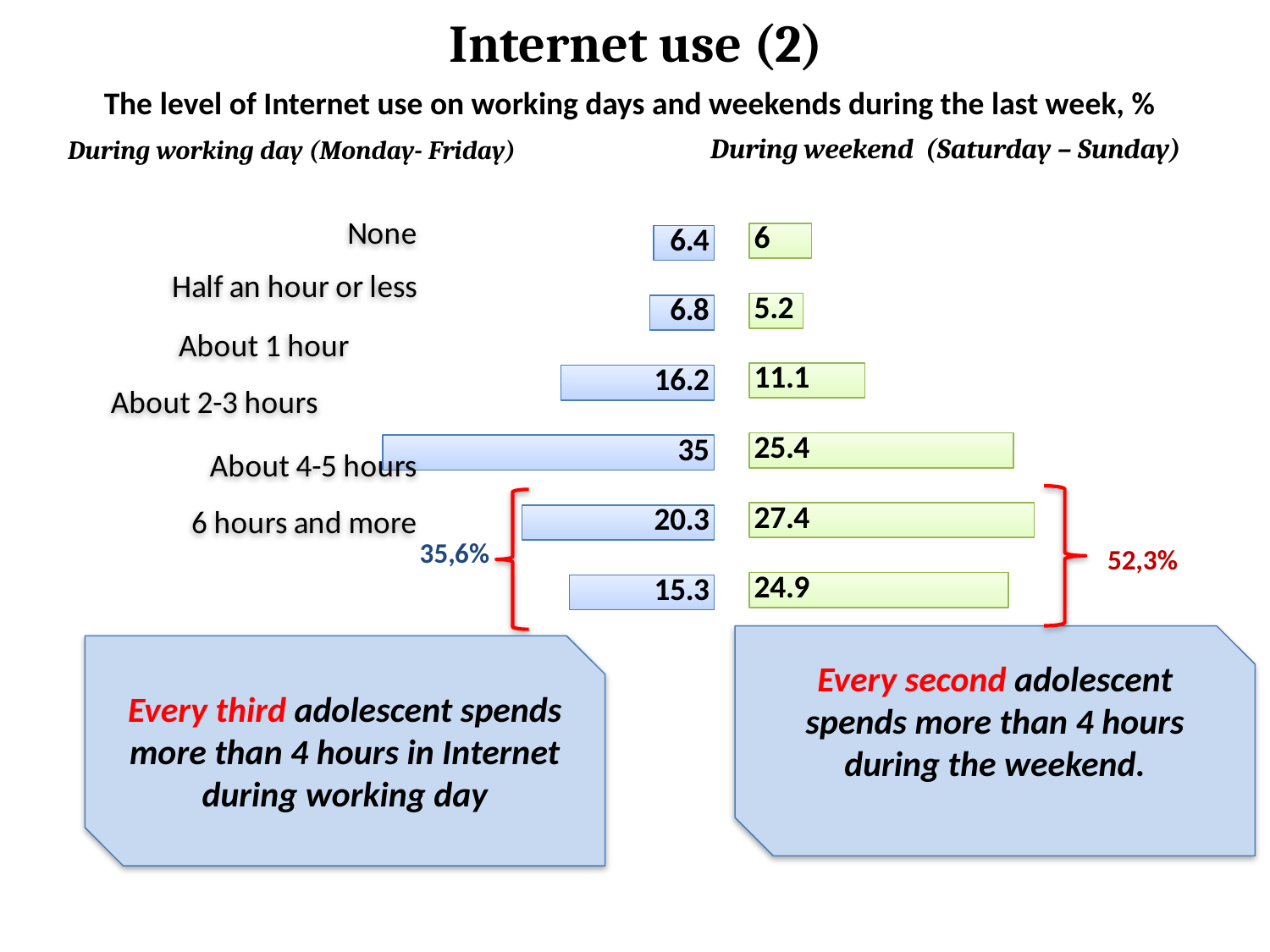
In the 'During working day (Monday- Friday)' chart, what is the value for 'Half an hour or less'? 6.8 What is the difference between the 'About 2-3 hours' values in the working day chart and the weekend chart? 9.6 What type of chart is used for the 'During weekend (Saturday – Sunday)' data? Bar chart In the 'During working day (Monday- Friday)' chart, what is the value for 'About 2-3 hours'? 35 In the 'During weekend (Saturday – Sunday)' chart, what is the value for '6 hours and more'? 24.9 In the 'During weekend (Saturday – Sunday)' chart, which category has the lowest value? Half an hour or less What colour are the bars in the 'During working day (Monday- Friday)' chart? Blue In the 'During weekend (Saturday – Sunday)' chart, which category has the highest value? About 4-5 hours How many categories does the 'During working day (Monday- Friday)' chart show? 6 In the 'During working day (Monday- Friday)' chart, which category has the highest value? About 2-3 hours Is the value for '6 hours and more' larger in the working day chart or the weekend chart? Weekend chart In the 'During weekend (Saturday – Sunday)' chart, what is the value for 'About 4-5 hours'? 27.4